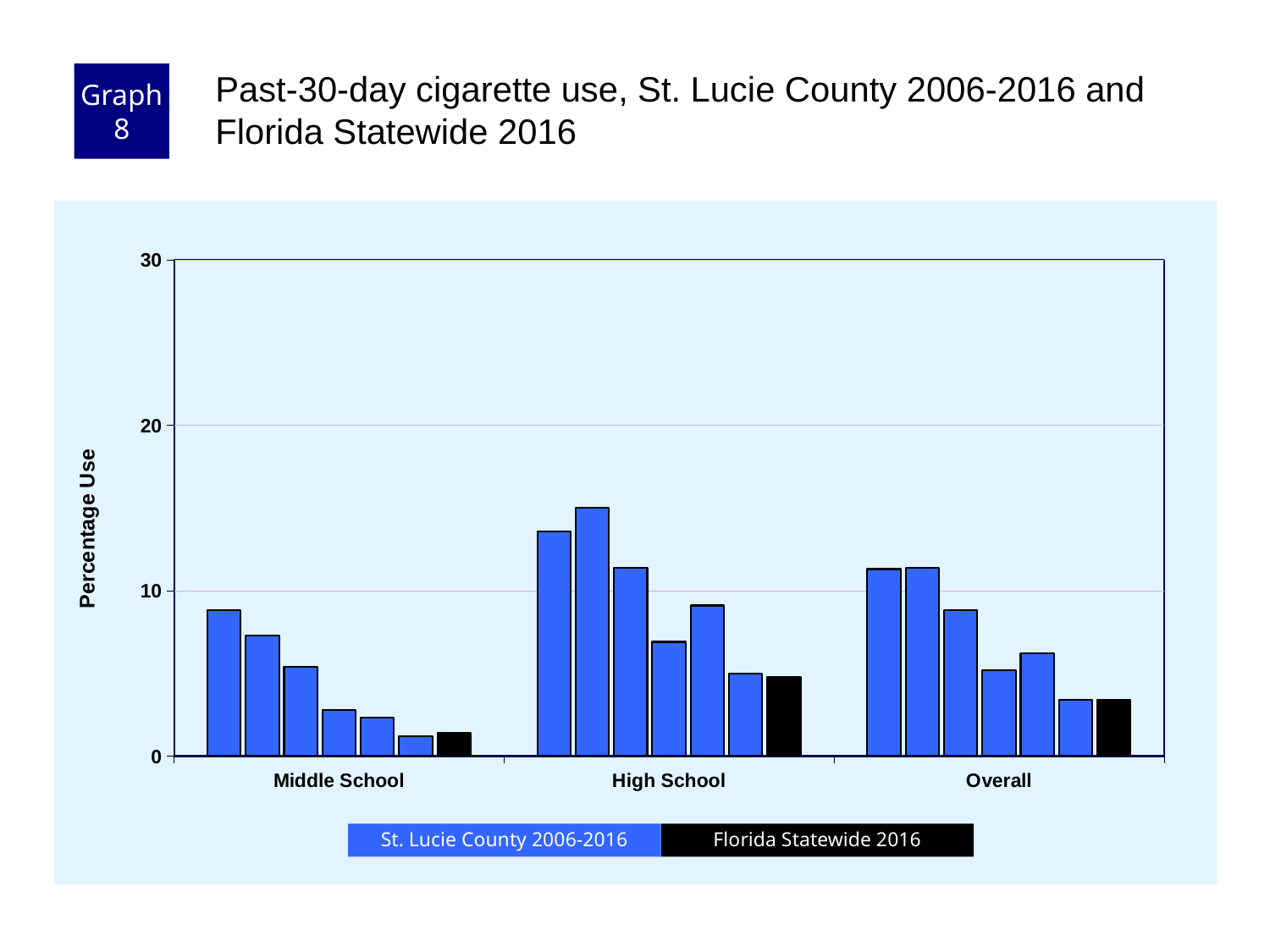
Is the Florida Statewide 2016 value for High School greater or less than 10? less What is the label on the y axis? Percentage Use Do the St. Lucie County bars in the Middle School group rise or fall from left to right? fall Which is larger, the Florida Statewide 2016 value for High School or for Middle School? High School Is the tallest St. Lucie County bar in the High School group greater or less than 10? greater Which category contains the tallest bar in the chart? High School How many series does the legend list? 2 Is the tallest St. Lucie County bar in the Middle School group greater or less than 10? less What colour are the Florida Statewide 2016 bars? black How many categories are shown along the x axis? 3 What kind of chart is shown on the slide? bar chart